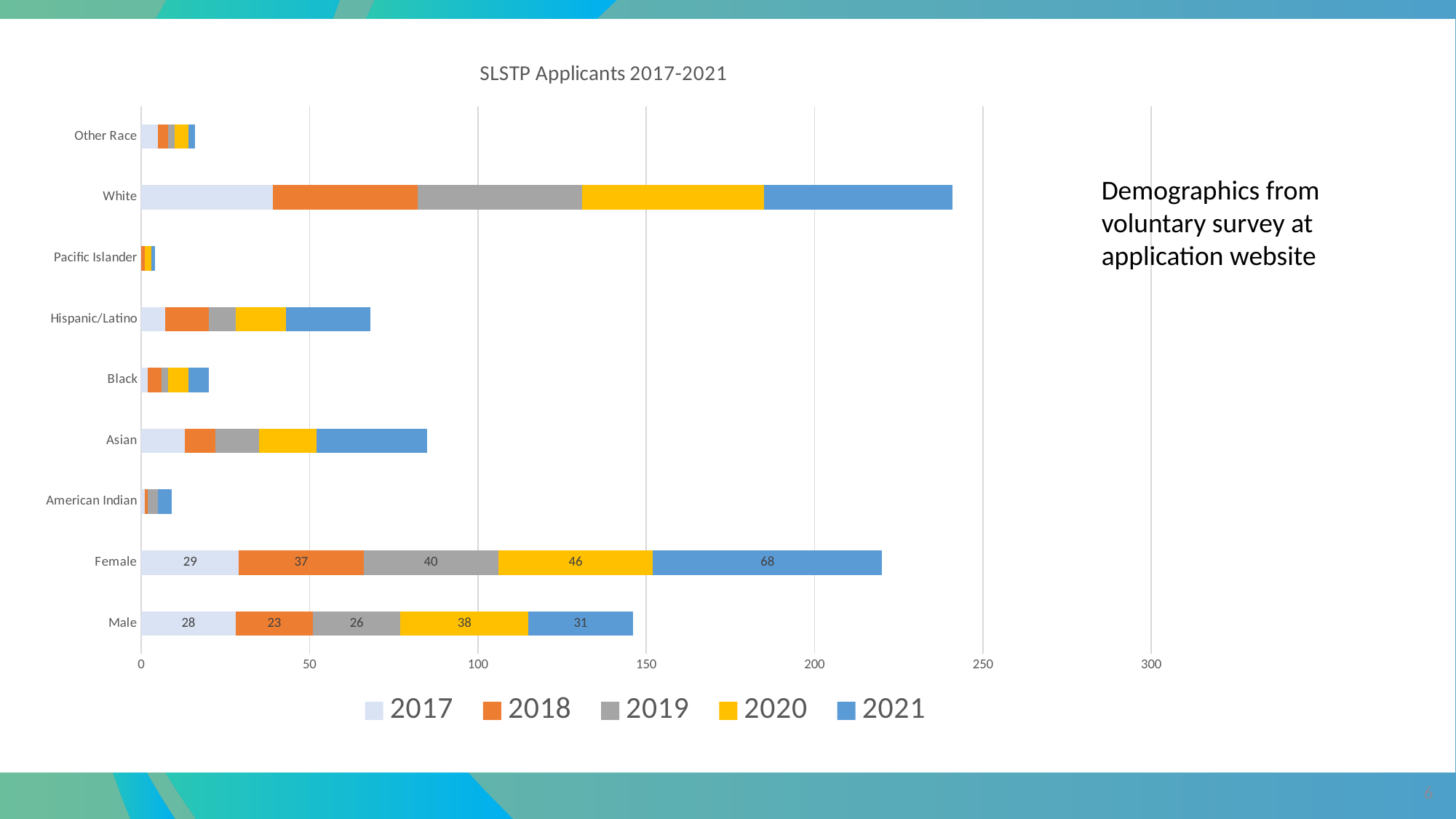
What is the value for Male in 2020? 38 What is the value for Female in 2021? 68 How many categories are shown on the vertical axis? 9 What is the total of the stacked bar for Male? 146 What is the total of the stacked bar for Female? 220 How many series does the legend list? 5 What is the difference between the Female and Male values for 2018? 14 What type of chart is shown on the slide? Stacked bar chart Is the total value for Asian greater or less than 100? less Which is larger, the Male value for 2017 or the Male value for 2018? Male 2017 Which category has the longest stacked bar overall? White What is the title of the chart? SLSTP Applicants 2017-2021